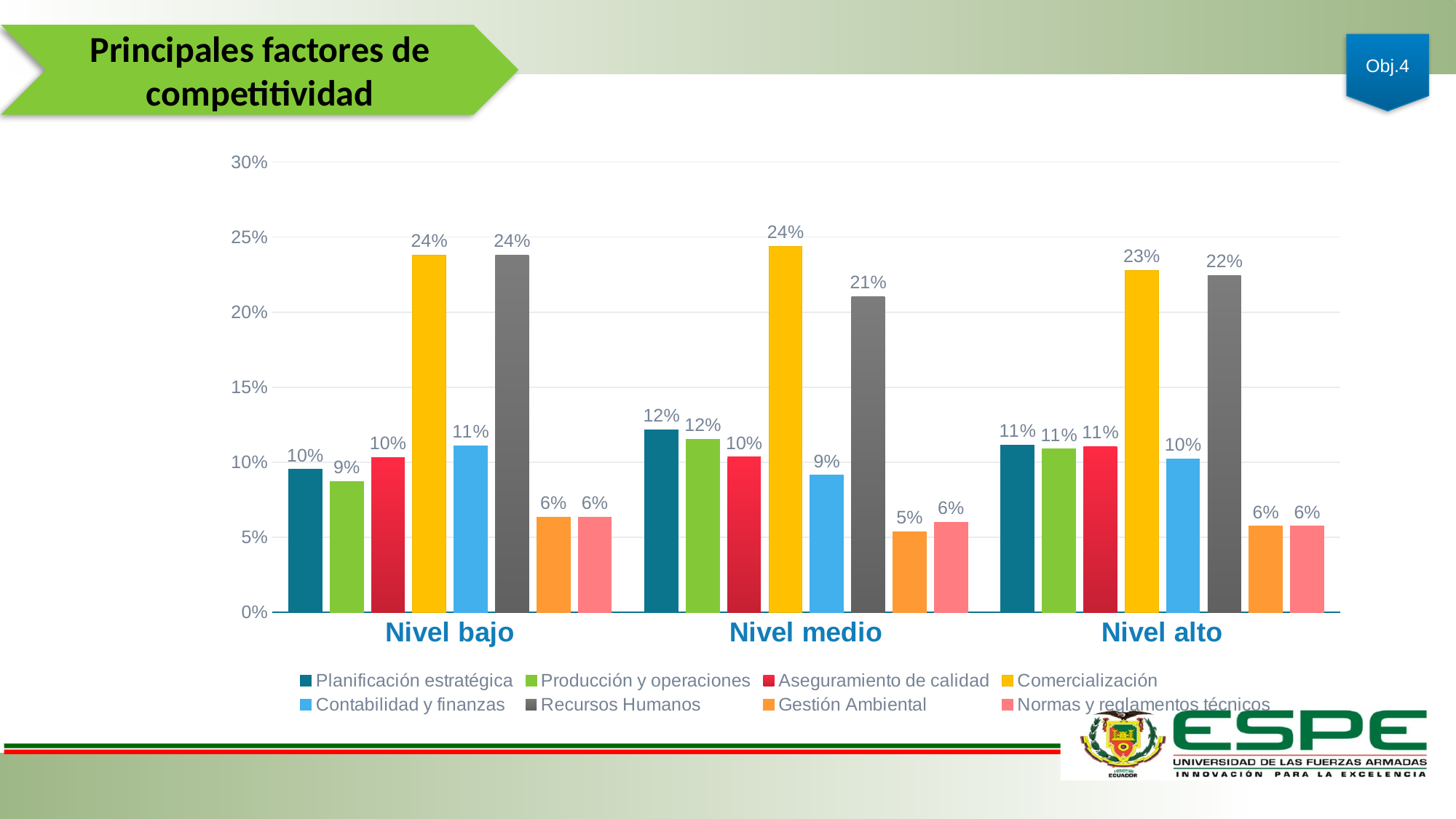
What is the value for Gestión Ambiental in the Nivel medio group? 5% Which series has the lowest value in the Nivel medio group? Gestión Ambiental Is the value for Comercialización in the Nivel alto group greater or less than 20%? greater Which series has the highest value in the Nivel medio group? Comercialización What is the value for Contabilidad y finanzas in the Nivel alto group? 10% How many series does the legend list? 8 In the Nivel medio group, what is the difference between Comercialización and Recursos Humanos? 3% What is the value for Comercialización in the Nivel bajo group? 24% What is the value for Recursos Humanos in the Nivel medio group? 21% Is the value for Recursos Humanos larger in the Nivel bajo group or the Nivel alto group? Nivel bajo How many categories are shown on the x axis? 3 What kind of chart is shown on the slide? Bar chart